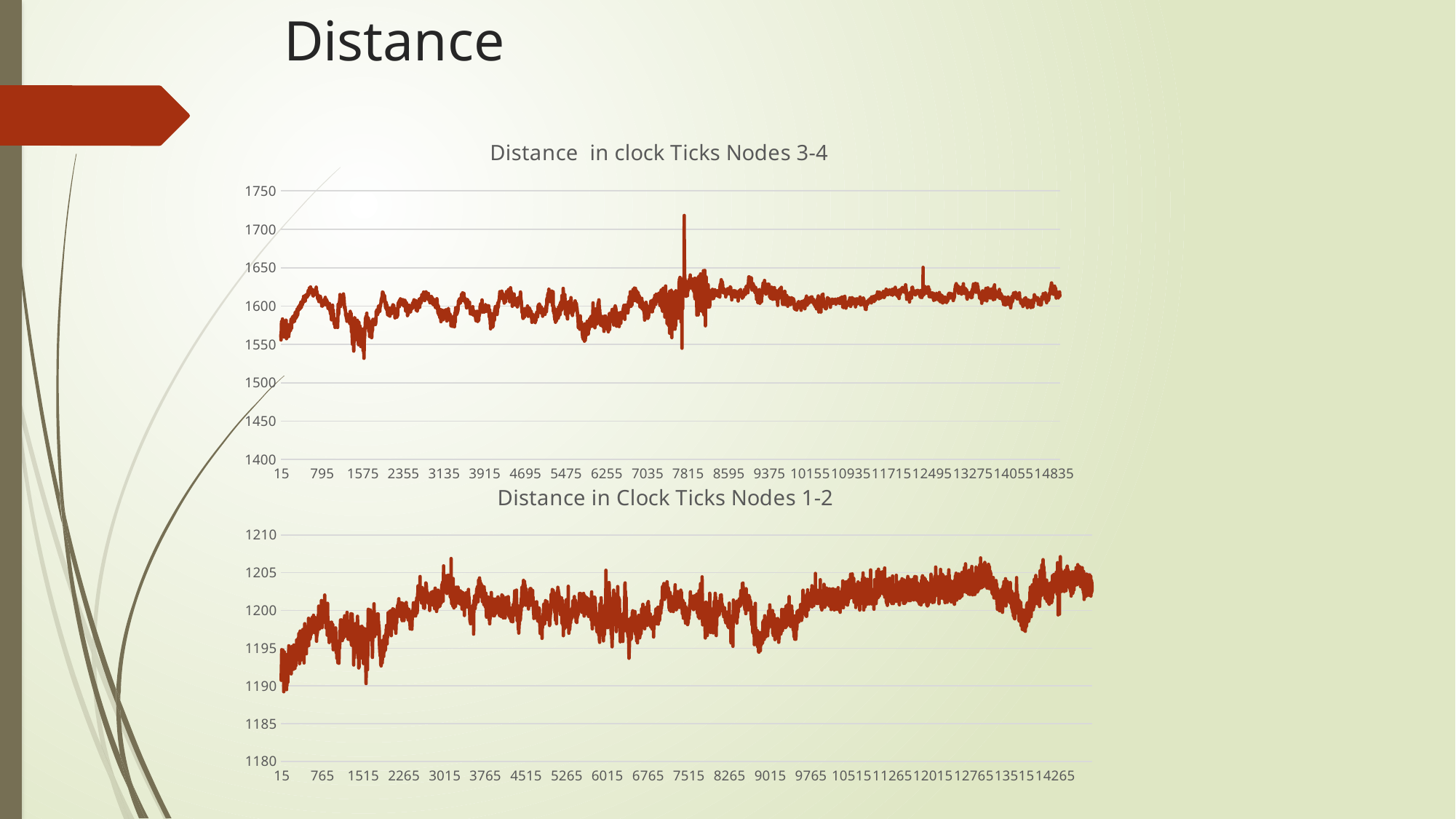
In the top chart 'Distance in clock Ticks Nodes 3-4', is the highest spike in the line greater or less than 1700? greater In the bottom chart 'Distance in Clock Ticks Nodes 1-2', is the value at the first x tick (15) greater or less than 1195? less In the bottom chart 'Distance in Clock Ticks Nodes 1-2', are the values near the last x tick (14265) greater or less than 1200? greater What is the title of the top chart on the slide? Distance in clock Ticks Nodes 3-4 Which chart shows larger distance values overall, 'Distance in clock Ticks Nodes 3-4' or 'Distance in Clock Ticks Nodes 1-2'? Distance in clock Ticks Nodes 3-4 In the bottom chart 'Distance in Clock Ticks Nodes 1-2', do the values generally rise or fall from left to right along the x axis? rise What kind of chart is the top chart, 'Distance in clock Ticks Nodes 3-4'? line chart What is the highest tick value shown on the y axis of the top chart 'Distance in clock Ticks Nodes 3-4'? 1750 What kind of chart is the bottom chart, 'Distance in Clock Ticks Nodes 1-2'? line chart What is the title of the bottom chart on the slide? Distance in Clock Ticks Nodes 1-2